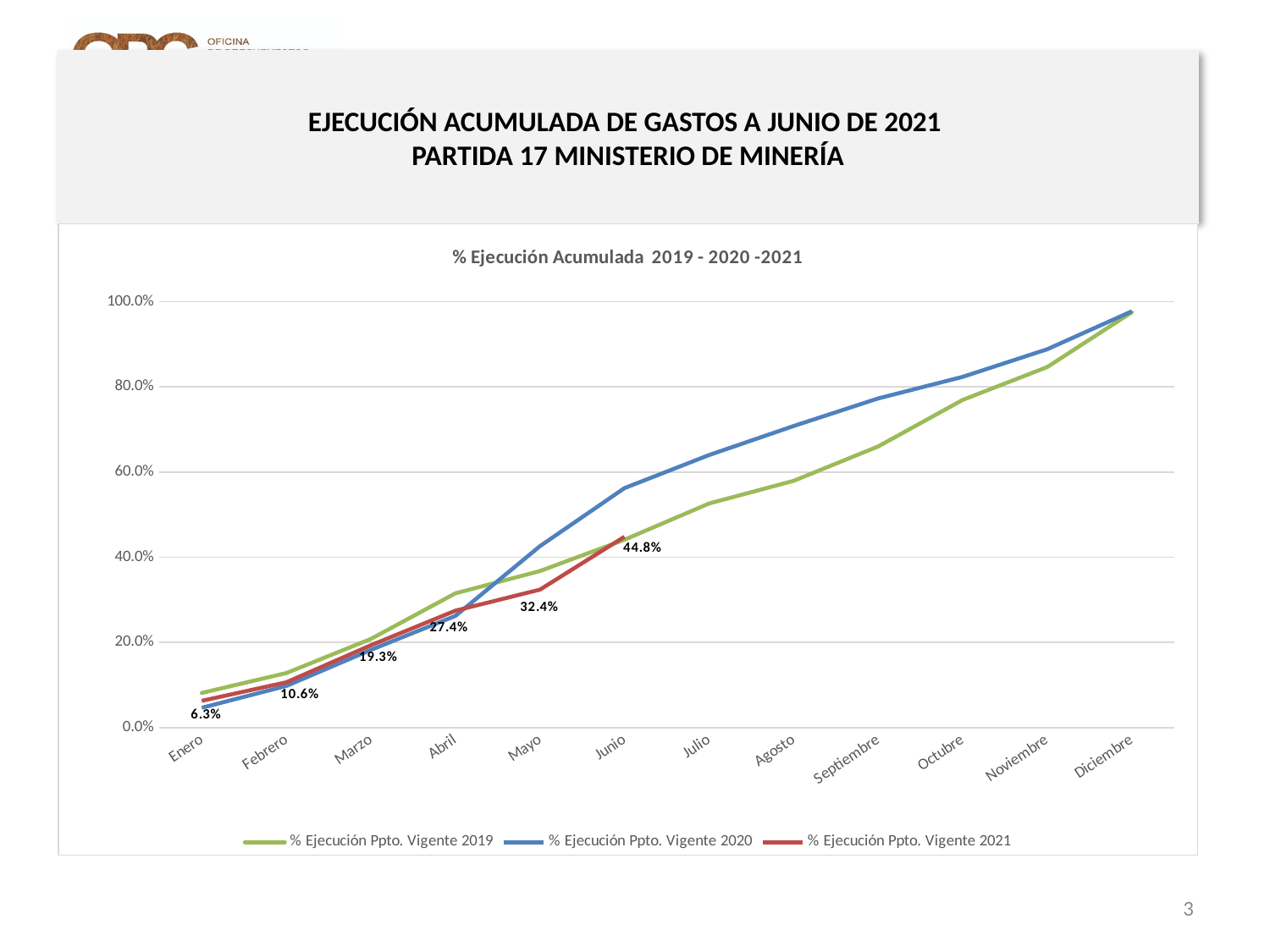
How many series does the legend list? 3 What is the title of the chart? % Ejecución Acumulada 2019 - 2020 -2021 How many months are shown on the x axis? 12 At Junio, which series has the larger value: % Ejecución Ppto. Vigente 2019 or % Ejecución Ppto. Vigente 2020? % Ejecución Ppto. Vigente 2020 Is the value for Junio in the % Ejecución Ppto. Vigente 2020 series greater or less than 40.0%? greater What is the difference between the Junio and Mayo values in the % Ejecución Ppto. Vigente 2021 series? 12.4% What is the value for Junio in the % Ejecución Ppto. Vigente 2021 series? 44.8% What kind of chart is shown on the slide? Line chart What is the value for Marzo in the % Ejecución Ppto. Vigente 2021 series? 19.3% Do the values of the % Ejecución Ppto. Vigente 2020 series rise or fall from Enero to Diciembre? Rise What is the value for Mayo in the % Ejecución Ppto. Vigente 2021 series? 32.4% What is the value for Enero in the % Ejecución Ppto. Vigente 2021 series? 6.3%